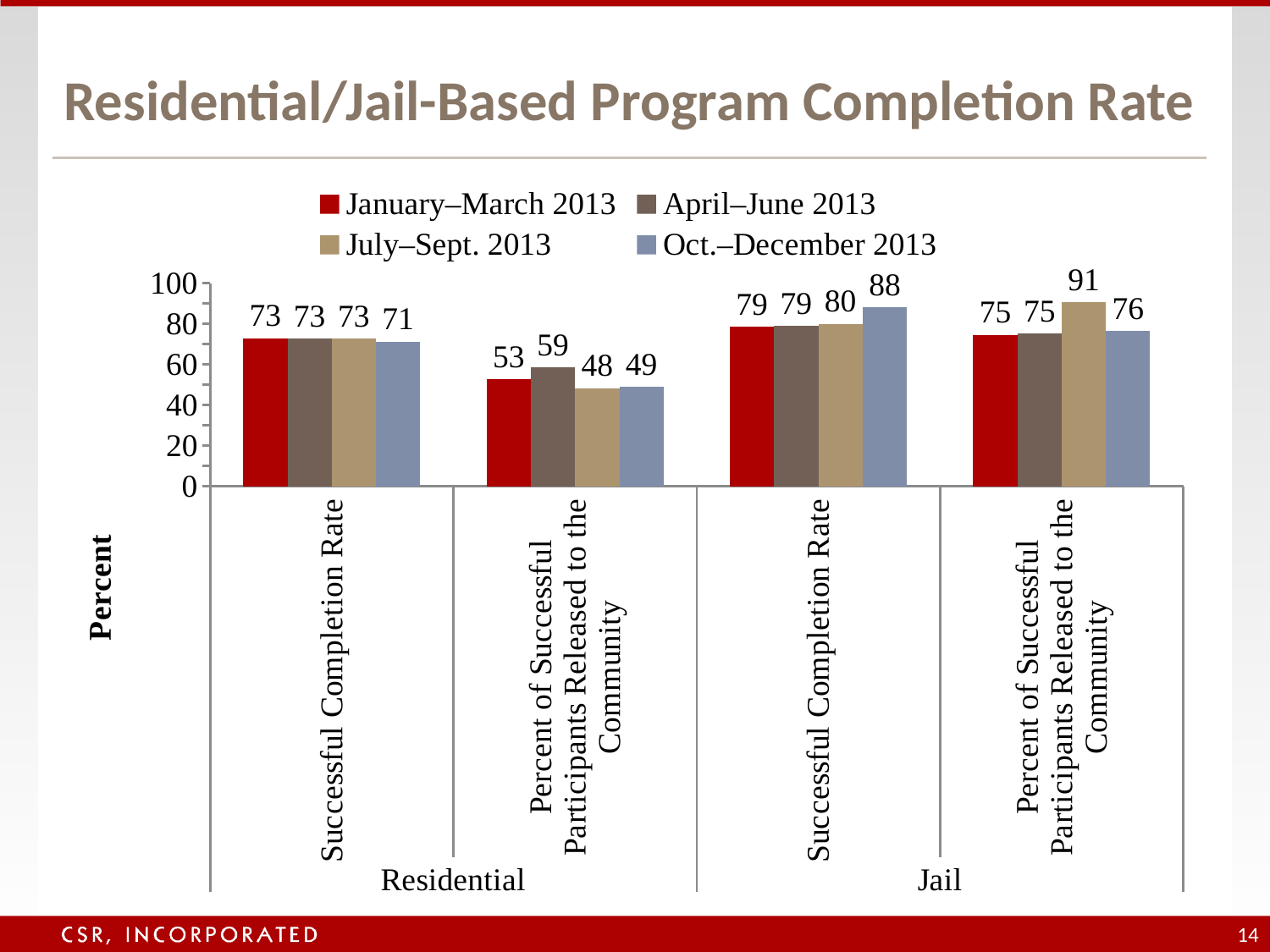
How many series does the legend list? 4 What is the Residential Percent of Successful Participants Released to the Community for April–June 2013? 59 Is the Residential Percent of Successful Participants Released to the Community for Oct.–December 2013 greater or less than 60? less What is the title of the chart? Residential/Jail-Based Program Completion Rate What is the Jail Percent of Successful Participants Released to the Community for July–Sept. 2013? 91 Which quarter has the lowest Residential Percent of Successful Participants Released to the Community? July–Sept. 2013 What is the difference between the Jail Successful Completion Rate for Oct.–December 2013 and for January–March 2013? 9 Which is larger: the Residential Successful Completion Rate for January–March 2013 or the Jail Successful Completion Rate for January–March 2013? Jail Successful Completion Rate What is the Jail Successful Completion Rate for Oct.–December 2013? 88 What is the Residential Successful Completion Rate for January–March 2013? 73 What kind of chart is shown on the slide? Bar chart Which quarter has the highest Jail Percent of Successful Participants Released to the Community? July–Sept. 2013